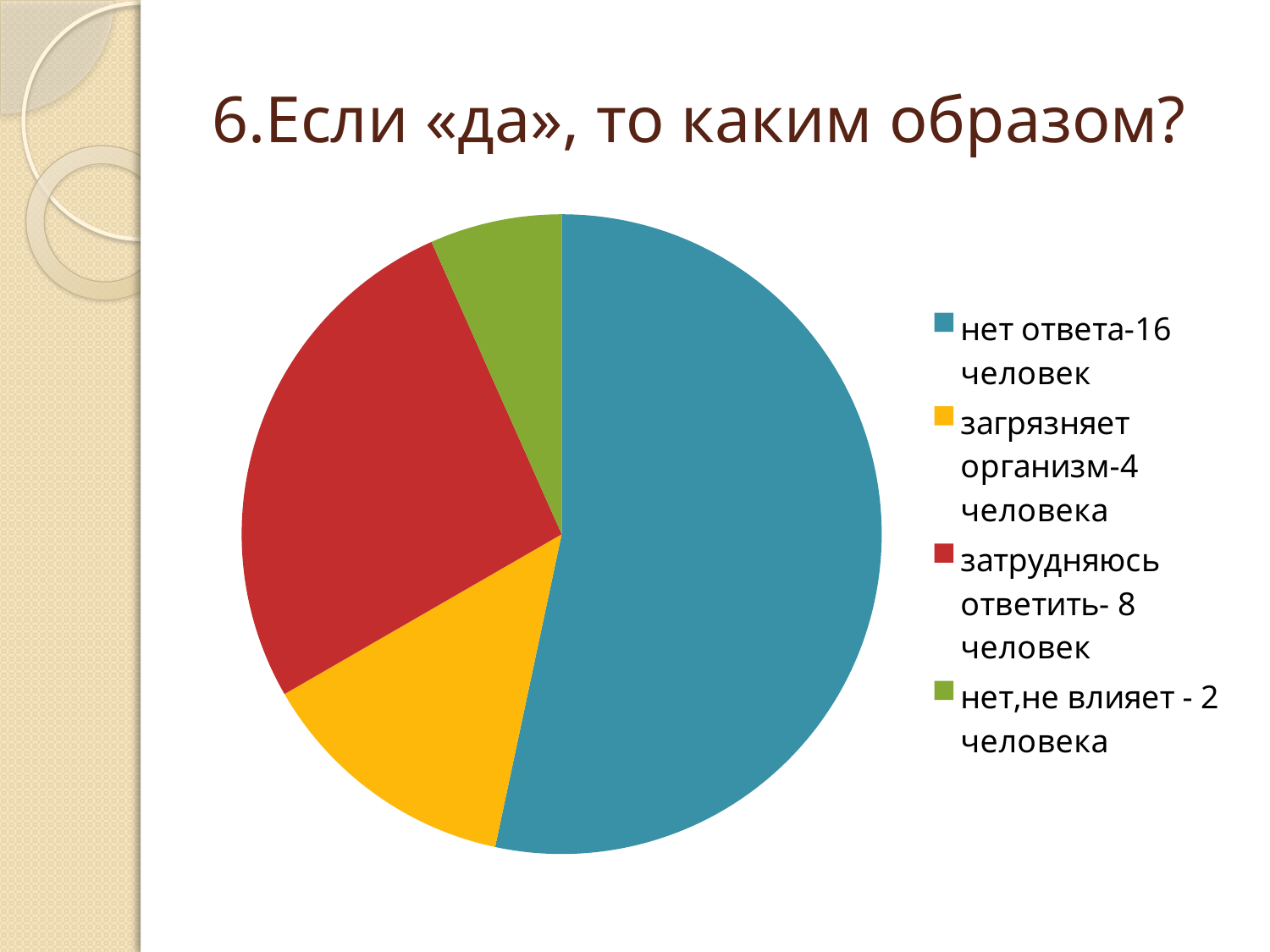
How many people answered "затрудняюсь ответить"? 8 человек Which category has the largest slice of the pie? нет ответа What is the total number of people across all categories in the pie chart? 30 What is the difference in number of people between "нет ответа" and "затрудняюсь ответить"? 8 What colour is the slice for "затрудняюсь ответить"? red What type of chart is shown on the slide? pie chart How many people answered "загрязняет организм"? 4 человека How many categories does the pie chart have? 4 How many people answered "нет,не влияет"? 2 человека Which is larger: "загрязняет организм" or "затрудняюсь ответить"? затрудняюсь ответить How many people are in the "нет ответа" category? 16 человек Which category has the smallest slice of the pie? нет,не влияет